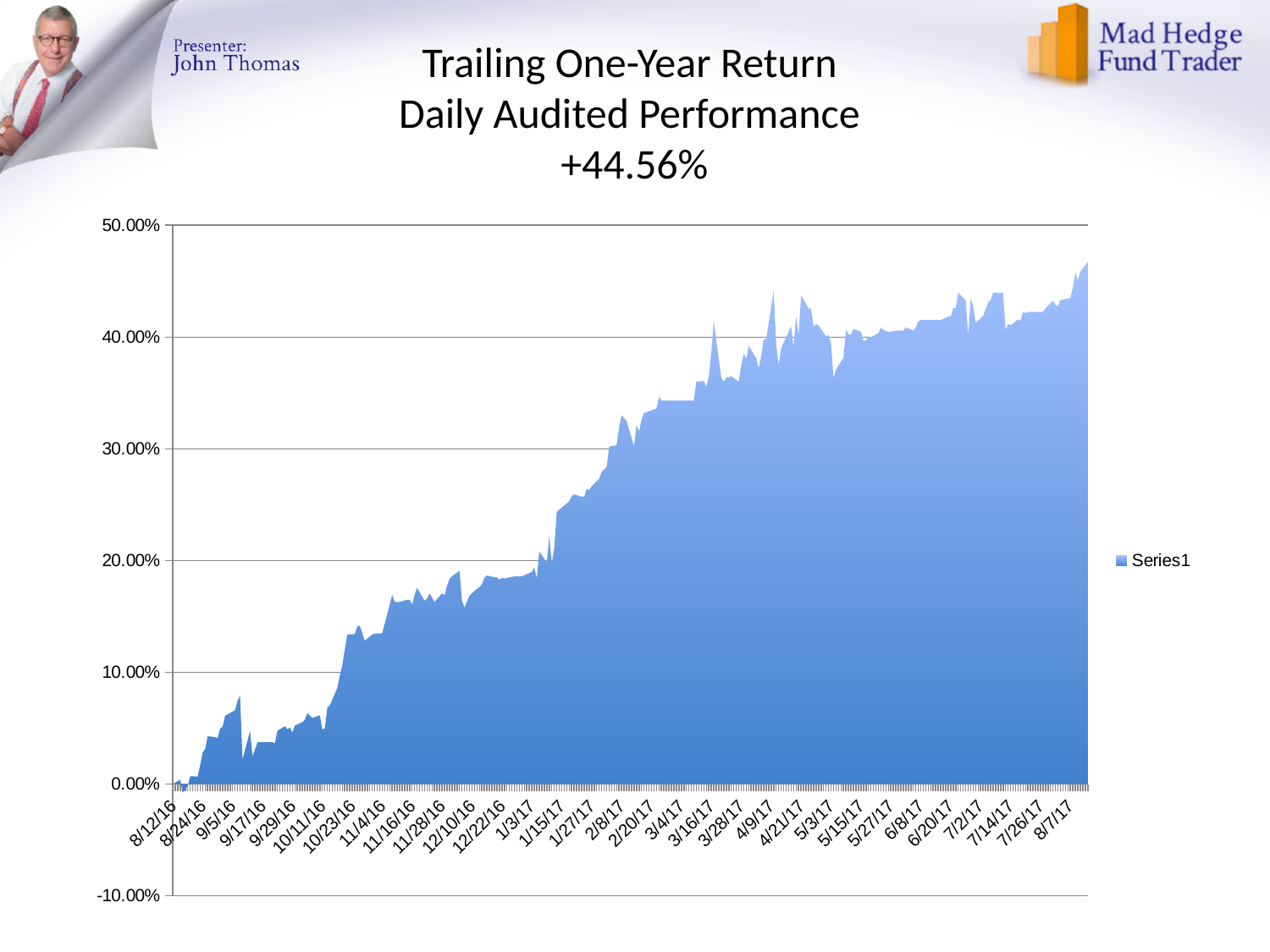
Is the value for 10/23/16 greater or less than 10.00%? greater How many series does the legend list? 1 What kind of chart is shown on the slide? area chart Do the values generally rise or fall from 8/12/16 to 8/7/17? rise Is the value for 11/16/16 greater or less than 20.00%? less Is the value for 3/4/17 greater or less than 30.00%? greater What trailing one-year return figure is stated in the chart title? +44.56% What is the name of the series shown in the legend? Series1